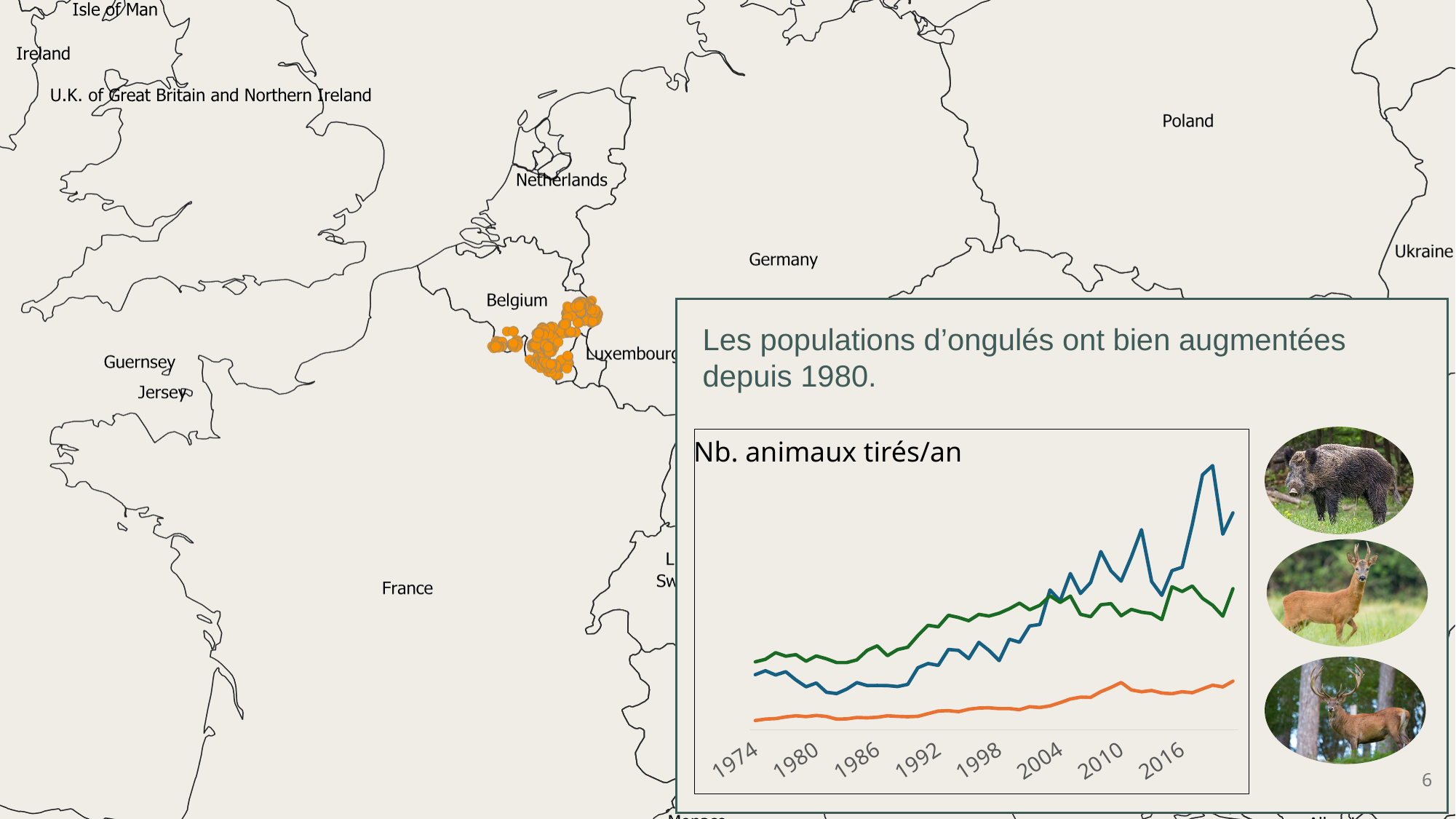
What is the title of the chart? Nb. animaux tirés/an At the right end of the chart, is the blue line or the green line higher? blue Which line reaches the highest point on the chart: the blue, green or orange line? blue At the left end of the chart (1974), is the green line or the blue line higher? green Which line is the lowest across the whole chart: the blue, green or orange line? orange Does the blue line generally rise or fall from 1974 to the end of the chart? rise What kind of chart is shown on the slide? line chart Does the orange line generally rise or fall over the period shown? rise How many year labels are shown on the x axis? 8 How many lines are plotted on the chart? 3 What is the first year label shown on the x axis? 1974 What is the last year label shown on the x axis? 2016